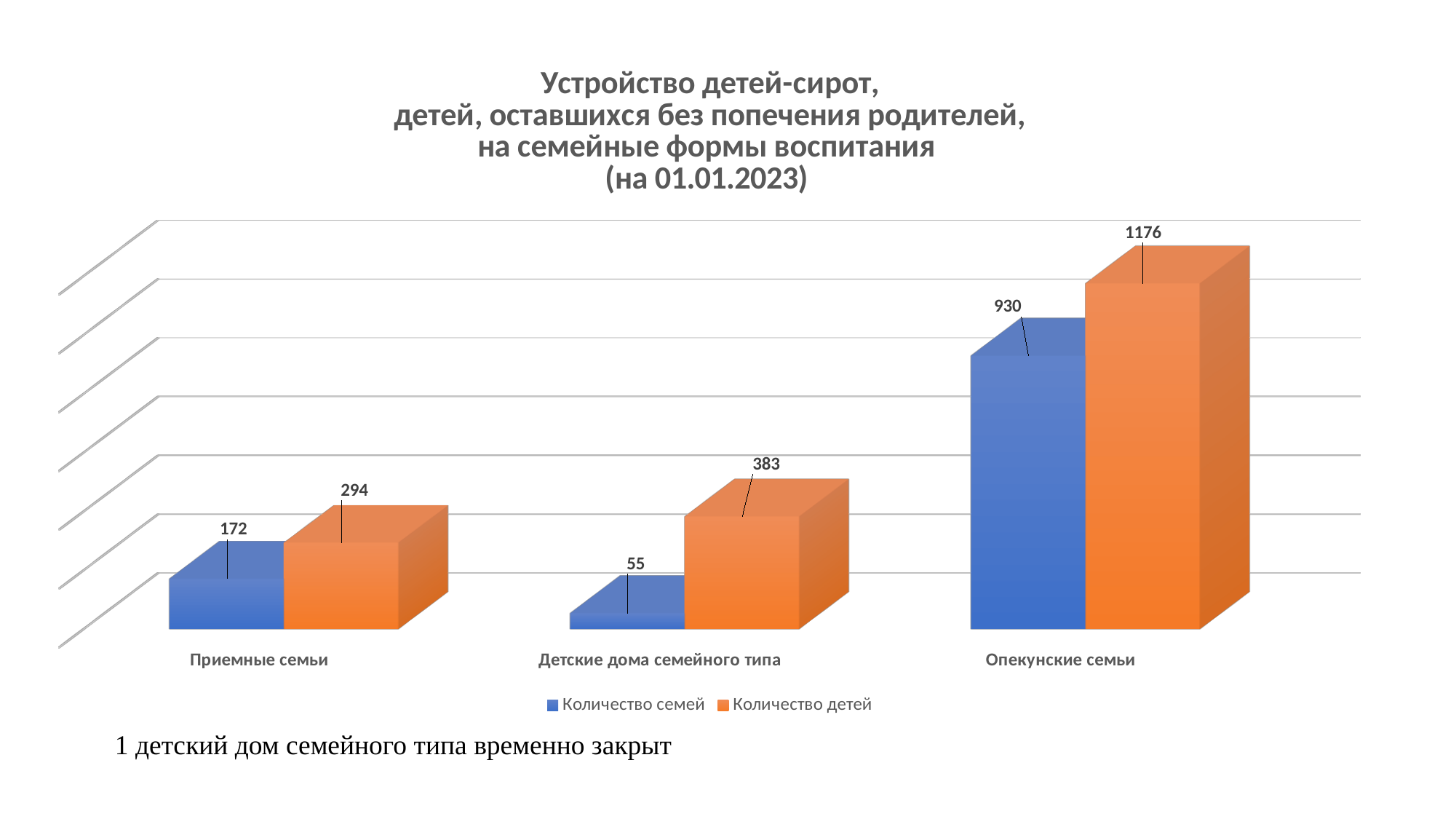
What is the value of Количество семей for Приемные семьи? 172 Which category has the highest value for Количество детей? Опекунские семьи What is the value of Количество семей for Детские дома семейного типа? 55 How many series does the legend list? 2 What kind of chart is shown on the slide? Bar chart What is the difference between Количество детей and Количество семей for Опекунские семьи? 246 Which category has the lowest value for Количество семей? Детские дома семейного типа What is the value of Количество детей for Приемные семьи? 294 What is the difference in Количество детей between Детские дома семейного типа and Приемные семьи? 89 What is the value of Количество детей for Опекунские семьи? 1176 Which is larger: Количество семей for Приемные семьи or Количество семей for Детские дома семейного типа? Приемные семьи How many categories are shown on the x axis? 3